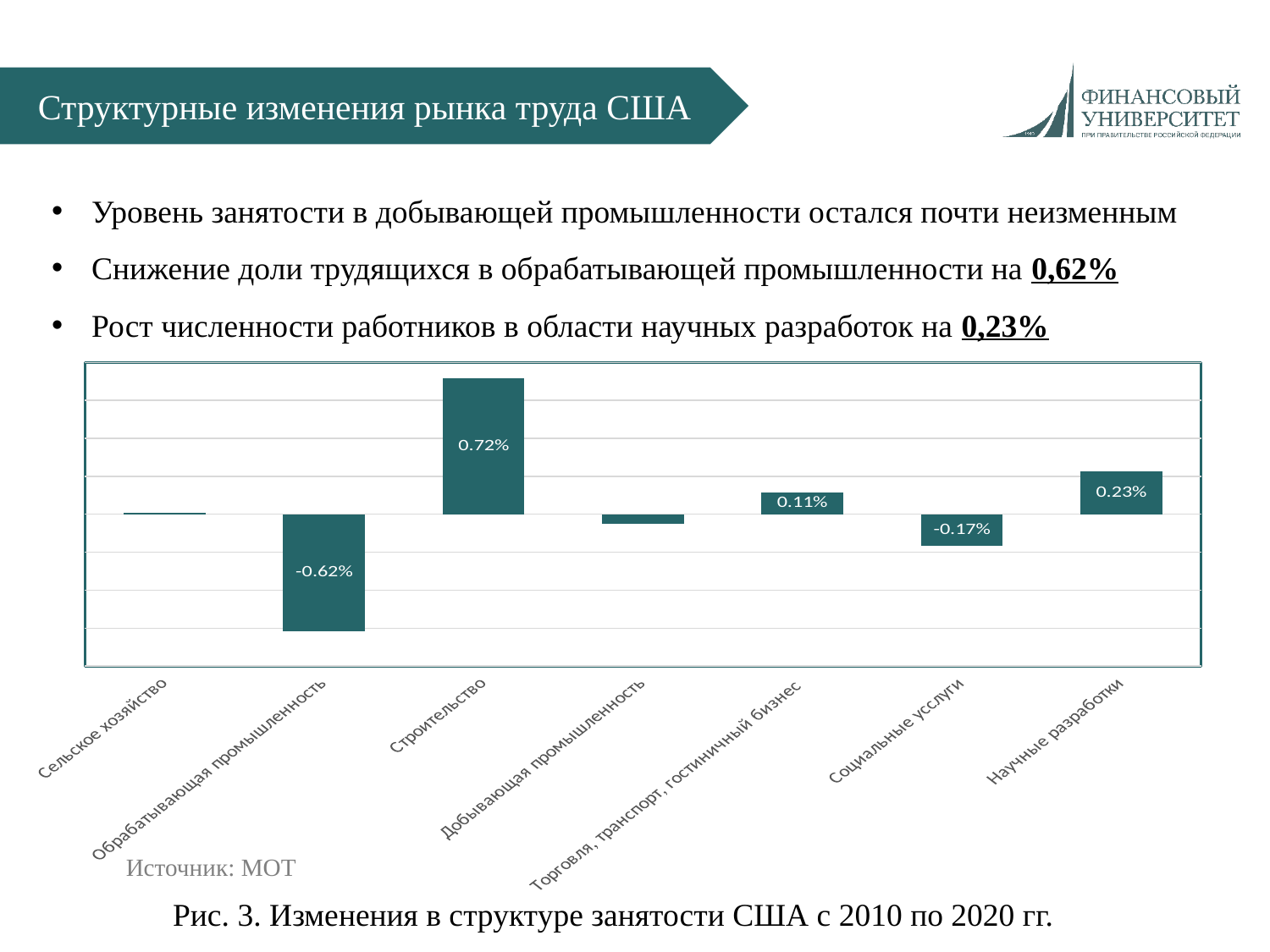
What is the value for Строительство? 0.72% What is the value for Социальные услуги? -0.17% What is the value for Обрабатывающая промышленность? -0.62% Which category has the highest value? Строительство What is the value for Научные разработки? 0.23% What kind of chart is shown on the slide? bar chart How many categories are shown on the x axis of the chart? 7 What source is cited below the chart? МОТ What is the value for Торговля, транспорт, гостиничный бизнес? 0.11% Which category has the lowest value? Обрабатывающая промышленность What is the difference between the values for Строительство and Научные разработки? 0.49% Which is larger, the value for Научные разработки or the value for Торговля, транспорт, гостиничный бизнес? Научные разработки